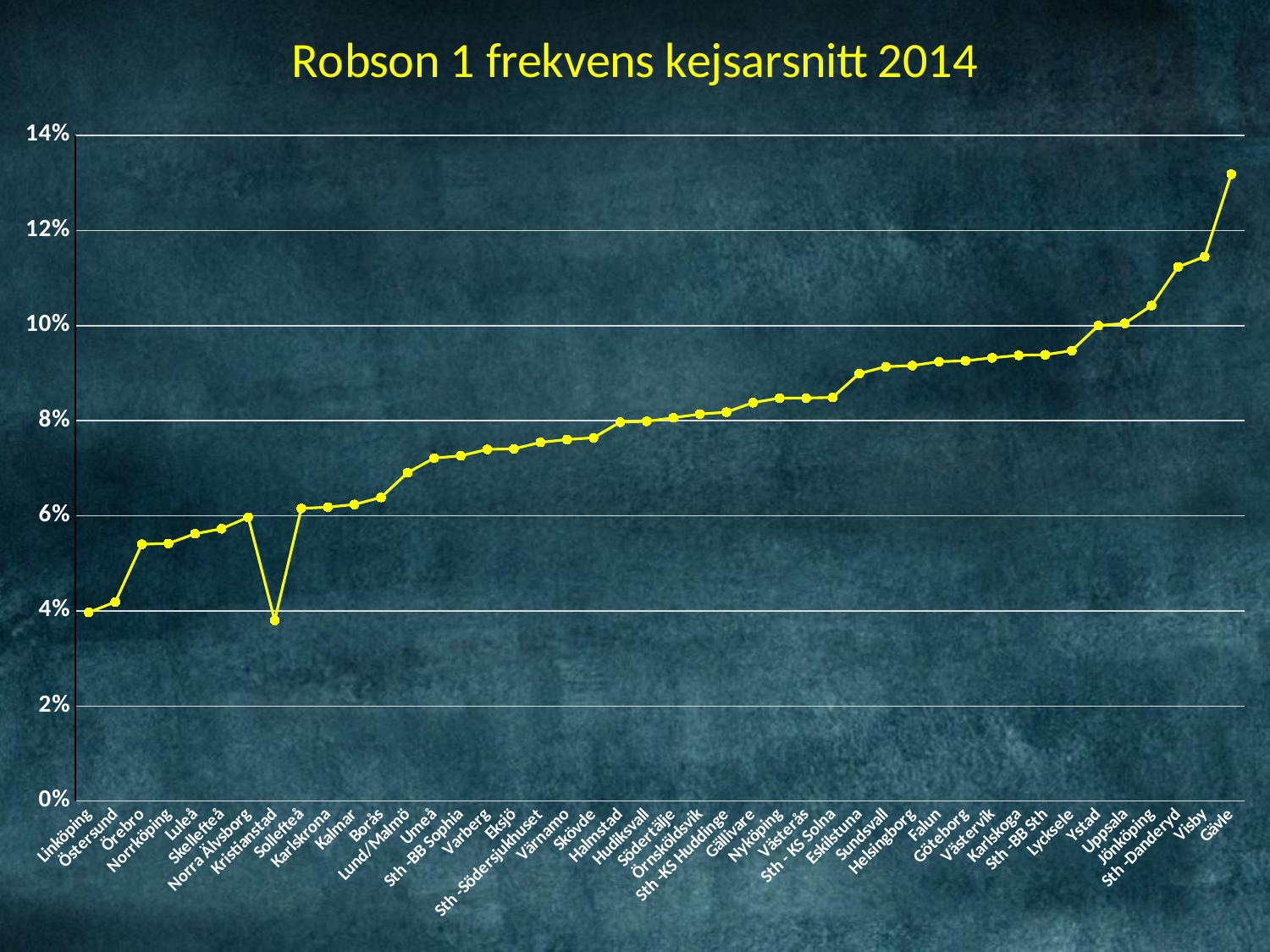
Which has a higher value, Visby or Uppsala? Visby Is the value for Visby greater or less than 10%? greater Which hospital has the lowest value in the chart? Kristianstad Which hospital has the highest value in the chart? Gävle Is the value for Gävle greater or less than 12%? greater Do the values generally rise or fall from left to right along the x axis? rise Is the value for Örebro greater or less than 6%? less Which has a higher value, Linköping or Gävle? Gävle What kind of chart is shown on the slide? line chart What is the title of the chart? Robson 1 frekvens kejsarsnitt 2014